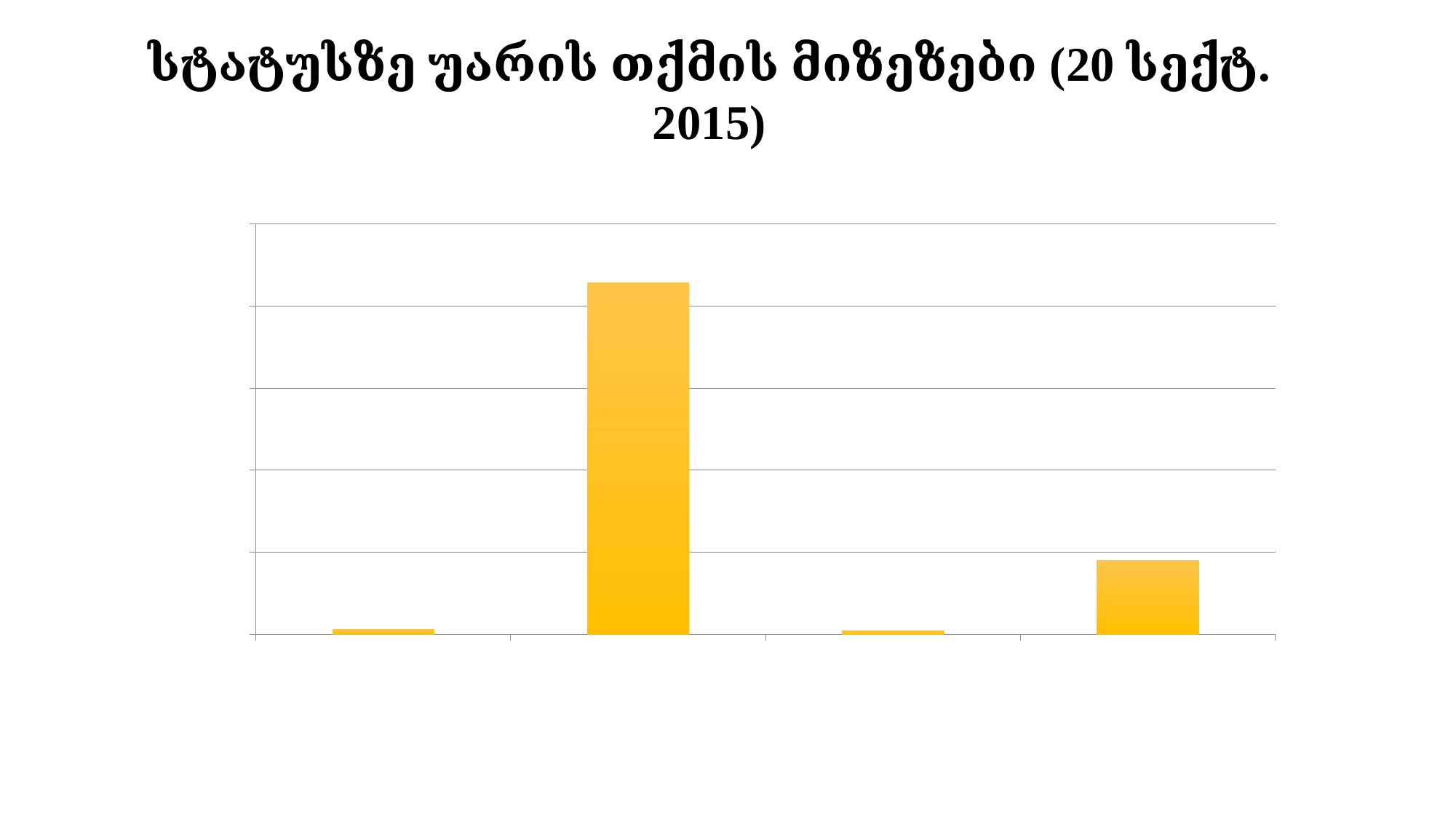
Which is larger, the second bar from the left or the fourth bar from the left? the second bar from the left What kind of chart is shown on the slide? bar chart Which is larger, the first bar from the left or the fourth bar from the left? the fourth bar from the left Which is larger, the third bar from the left or the fourth bar from the left? the fourth bar from the left Which year is mentioned in the chart's title? 2015 How many bars are plotted in the chart? 4 What colour are the bars in the chart? yellow Which bar is the highest in the chart? the second bar from the left